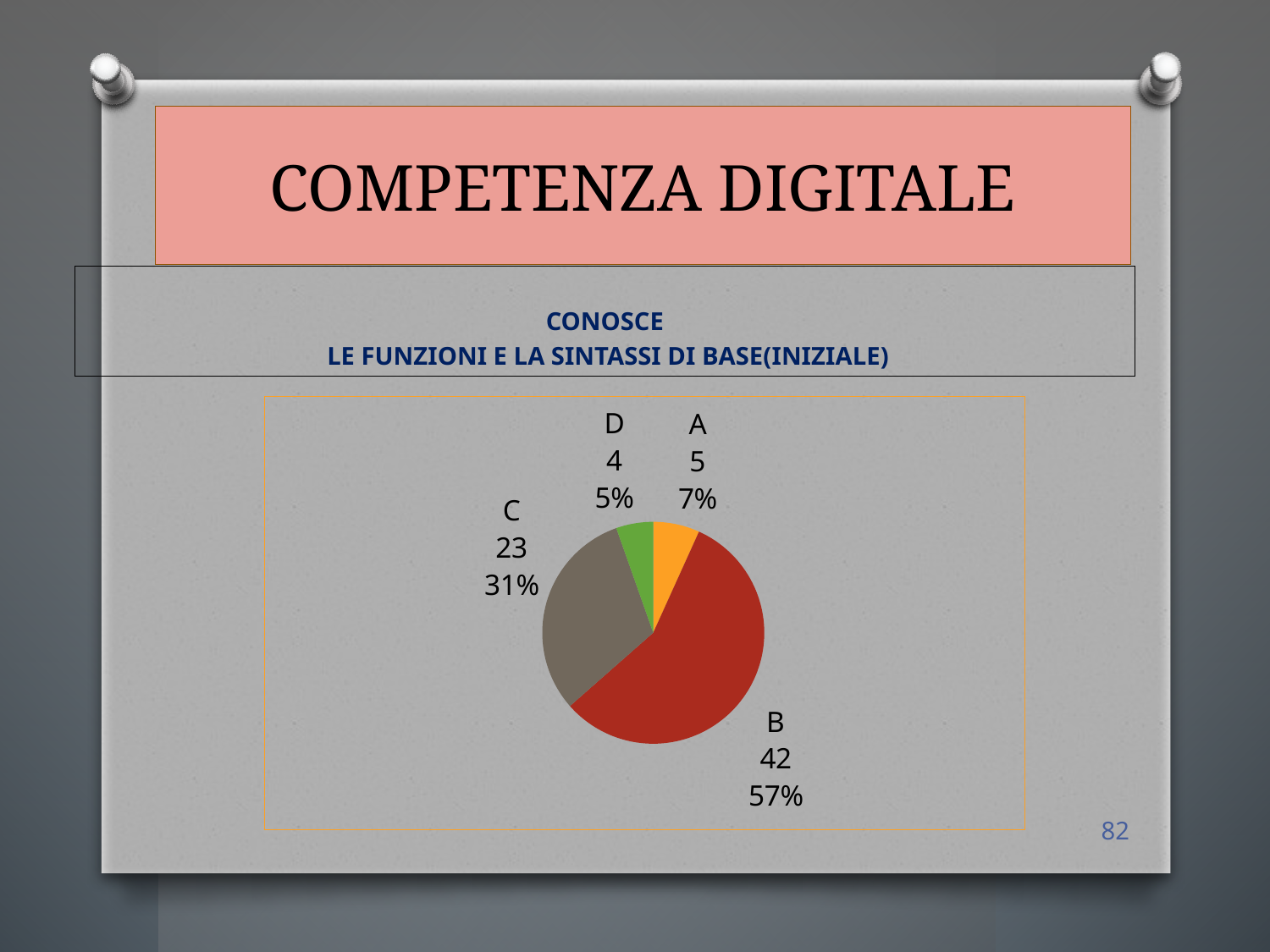
What is the value for category A? 5 How many slices does the pie chart have? 4 What is the value for category D? 4 Which category has the smallest slice? D What share of the pie does category B represent? 57% What is the value for category C? 23 What is the value for category B? 42 What kind of chart is shown on the slide? pie chart Which category has the largest slice? B What share of the pie does category C represent? 31% What is the difference between the values for B and C? 19 Which is larger, the value for A or the value for D? A